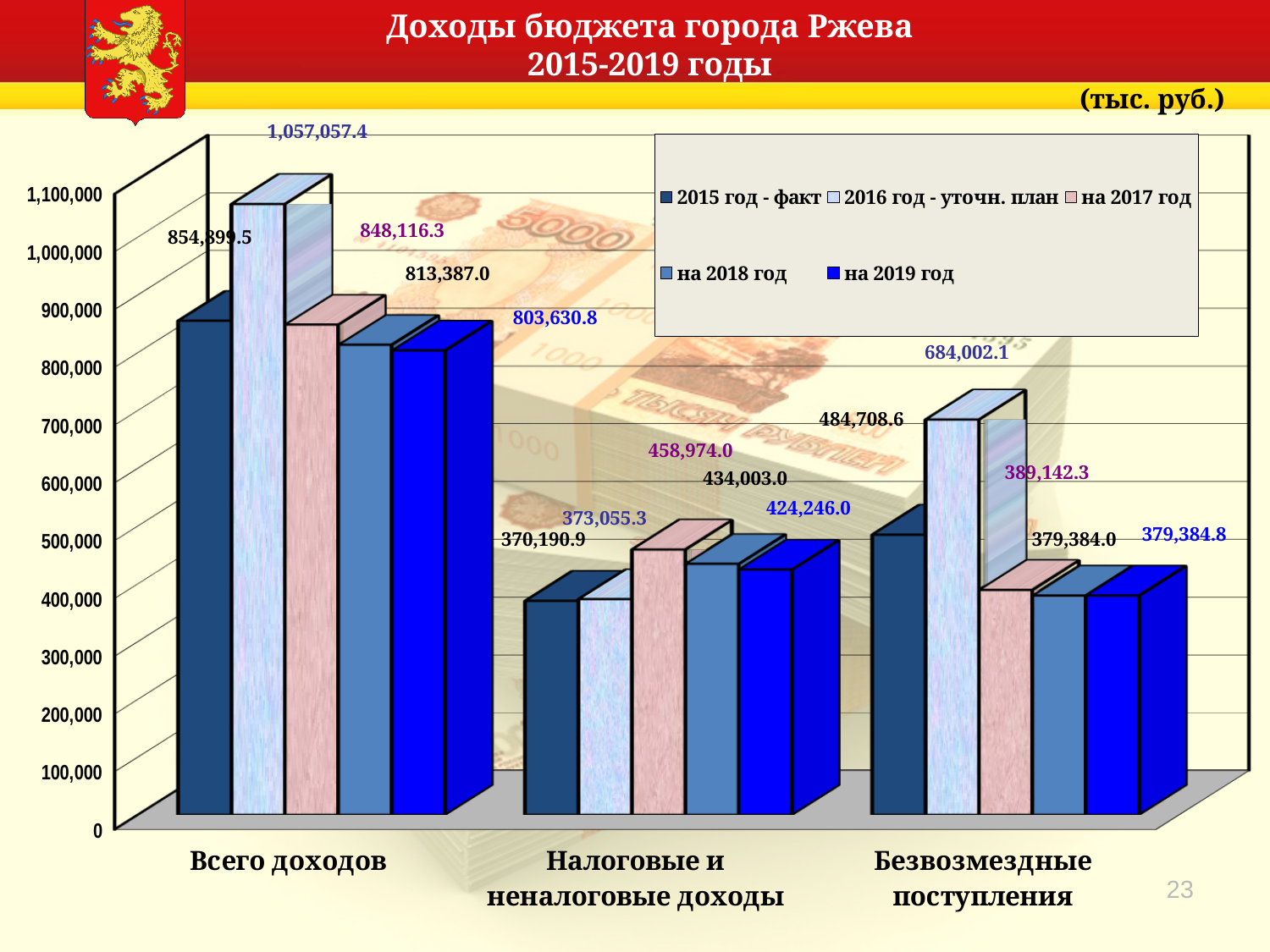
What is the value for 'Безвозмездные поступления' in the 'на 2019 год' series? 379,384.8 For 'Налоговые и неналоговые доходы', which is larger: the 'на 2018 год' value or the 'на 2019 год' value? на 2018 год What is the value for 'Всего доходов' in the '2016 год - уточн. план' series? 1,057,057.4 How many series does the legend list? 5 What is the value for 'Налоговые и неналоговые доходы' in the 'на 2017 год' series? 458,974.0 How many categories are shown on the x axis? 3 What kind of chart is shown on the slide? bar chart What is the difference between the '2016 год - уточн. план' and '2015 год - факт' values for 'Всего доходов'? 202,157.9 Which series has the highest value for 'Всего доходов'? 2016 год - уточн. план What is the difference between the '2016 год - уточн. план' and 'на 2017 год' values for 'Безвозмездные поступления'? 294,859.8 Which series has the lowest value for 'Всего доходов'? на 2019 год Is the '2015 год - факт' value for 'Безвозмездные поступления' greater or less than 400,000? greater